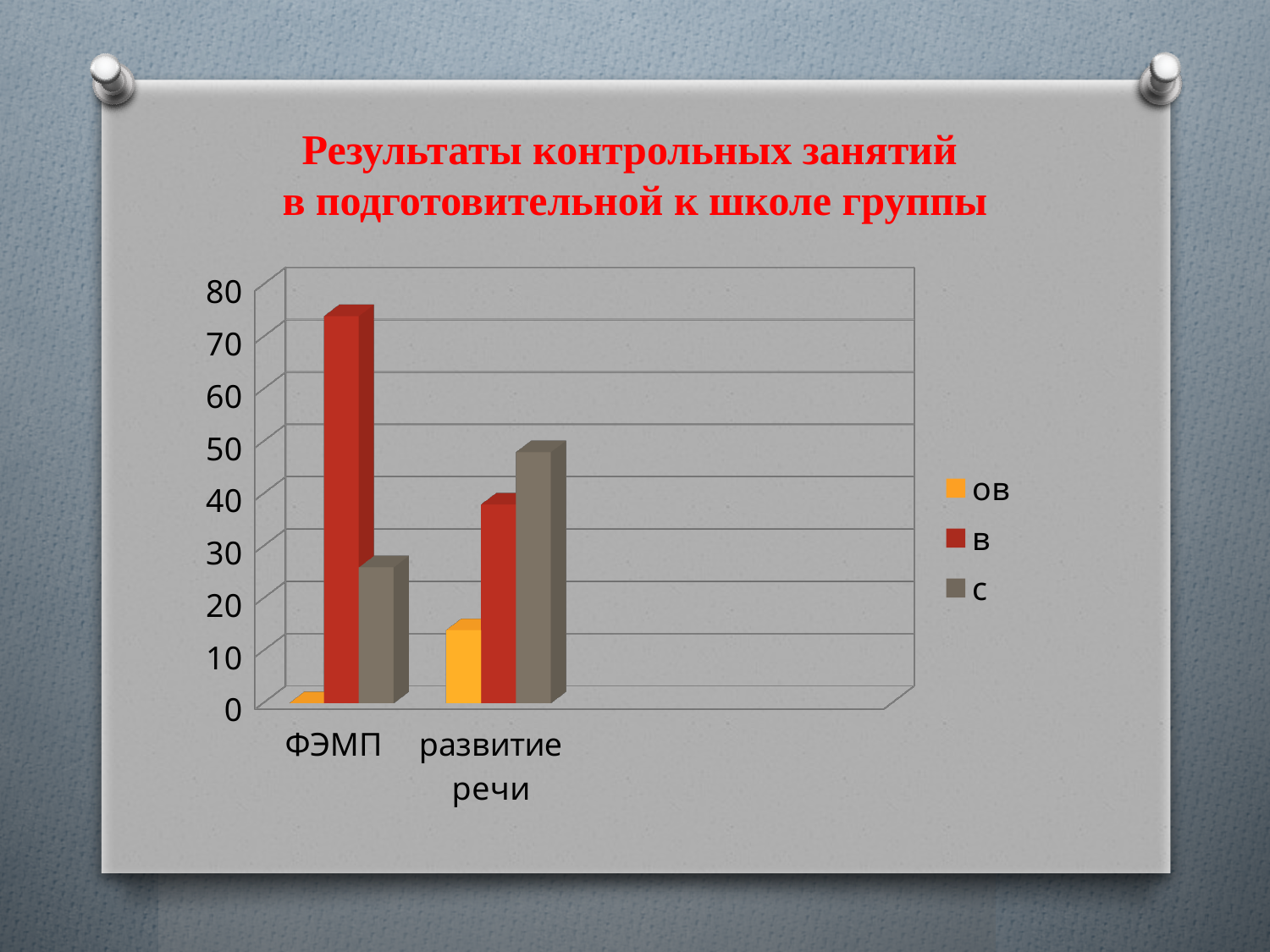
Which series has the lowest value for развитие речи? ов Is the value of series с for ФЭМП greater or less than 40? less Is the value of series в for ФЭМП greater or less than 70? greater Which series has the highest value for ФЭМП? в For развитие речи, which is larger: series в or series с? с Is the value of series с for развитие речи greater or less than 40? greater How many series does the legend list? 3 What colour represents series ов in the legend? orange Does the value of series в rise or fall from ФЭМП to развитие речи? fall How many categories are shown on the x axis? 2 What kind of chart is shown on the slide? bar chart